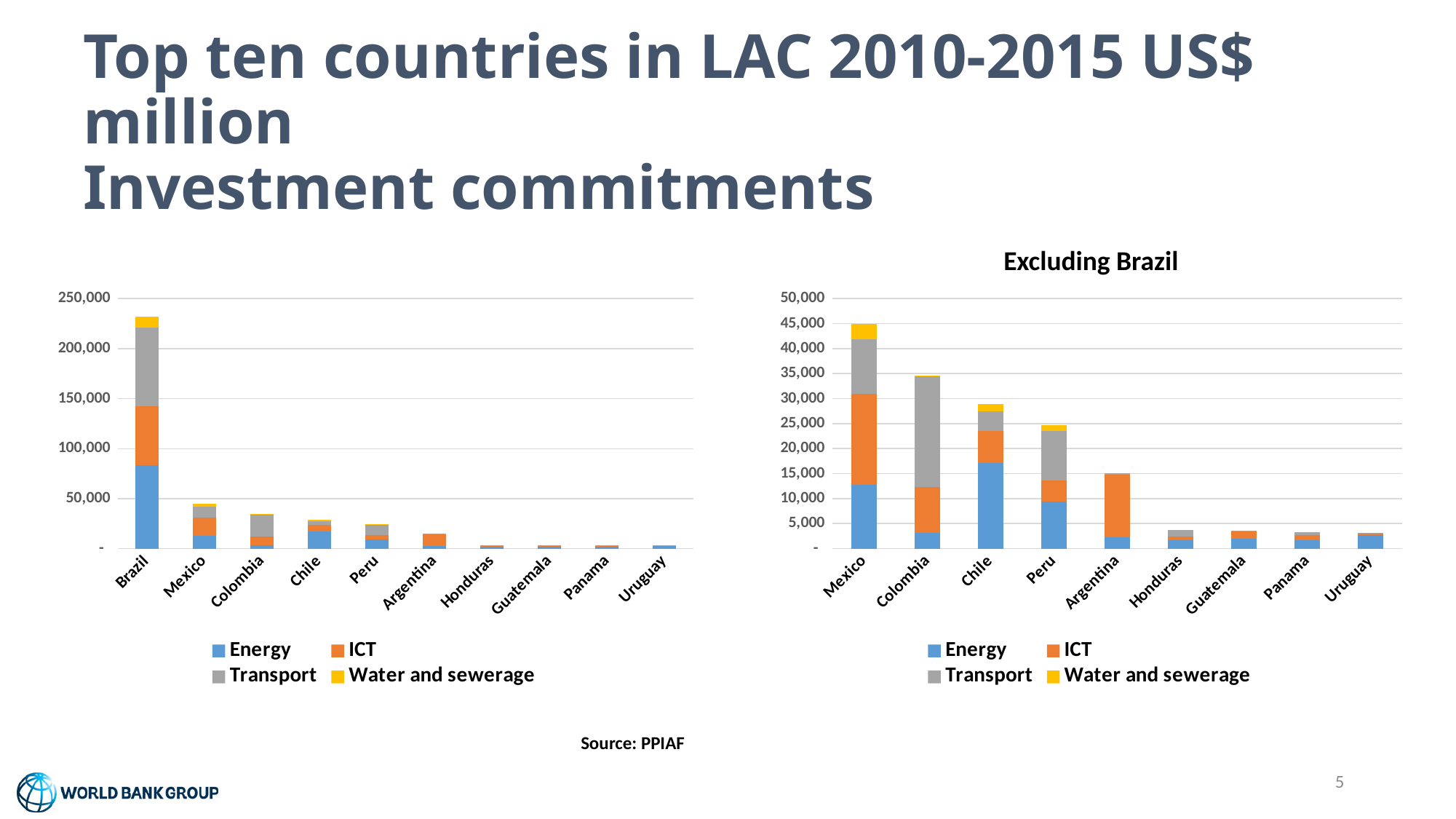
How many countries are shown on the x axis of the left chart? 10 In the 'Excluding Brazil' chart, do the total values rise or fall moving from left to right along the x axis? Fall In the left chart, which country has the highest total investment commitments? Brazil In the 'Excluding Brazil' chart, is the total value for Mexico greater or less than 40,000? greater In the 'Excluding Brazil' chart, which has the larger total, Mexico or Colombia? Mexico In the 'Excluding Brazil' chart, is the total value for Honduras greater or less than 5,000? less In the left chart, is the total value for Brazil greater or less than 200,000? greater What kind of chart is the left chart on the slide? Stacked bar chart What is the title of the right chart on the slide? Excluding Brazil In the 'Excluding Brazil' chart, which country has the highest total investment commitments? Mexico How many countries are shown on the x axis of the 'Excluding Brazil' chart? 9 How many series does the legend of the 'Excluding Brazil' chart list? 4